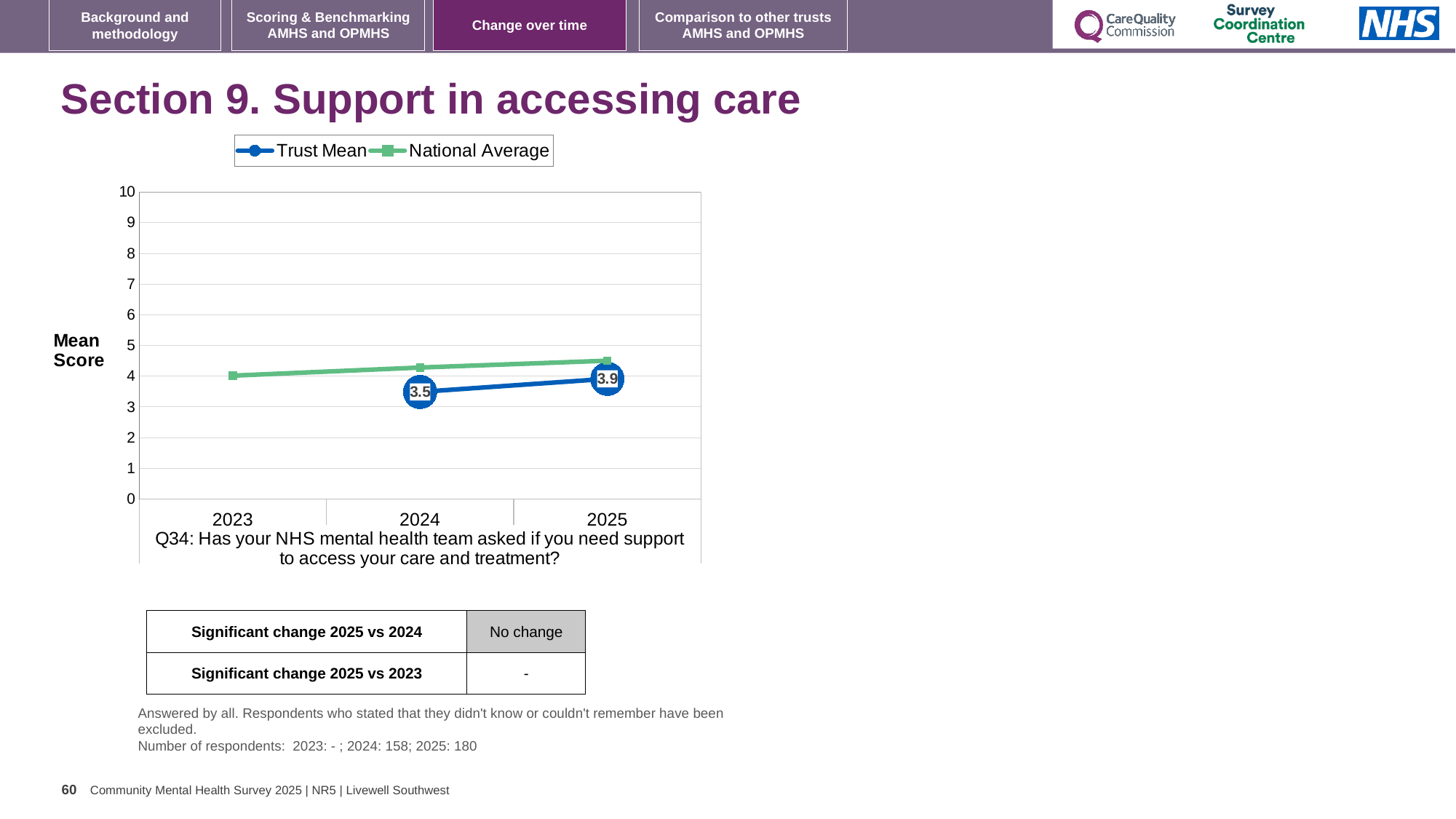
How many series does the legend list? 2 By how much did the Trust Mean score change from 2024 to 2025? 0.4 Is the National Average value for 2023 greater or less than 5? less What is the Trust Mean score for 2025? 3.9 Which year has the higher Trust Mean score, 2024 or 2025? 2025 What is the label on the vertical axis of the chart? Mean Score Does the Trust Mean line rise or fall from 2024 to 2025? rise What is the Trust Mean score for 2024? 3.5 Is the National Average value for 2025 greater or less than 3? greater In 2024, which series has the higher value, Trust Mean or National Average? National Average What kind of chart is shown on the slide? line chart Does the National Average line rise or fall from 2023 to 2025? rise